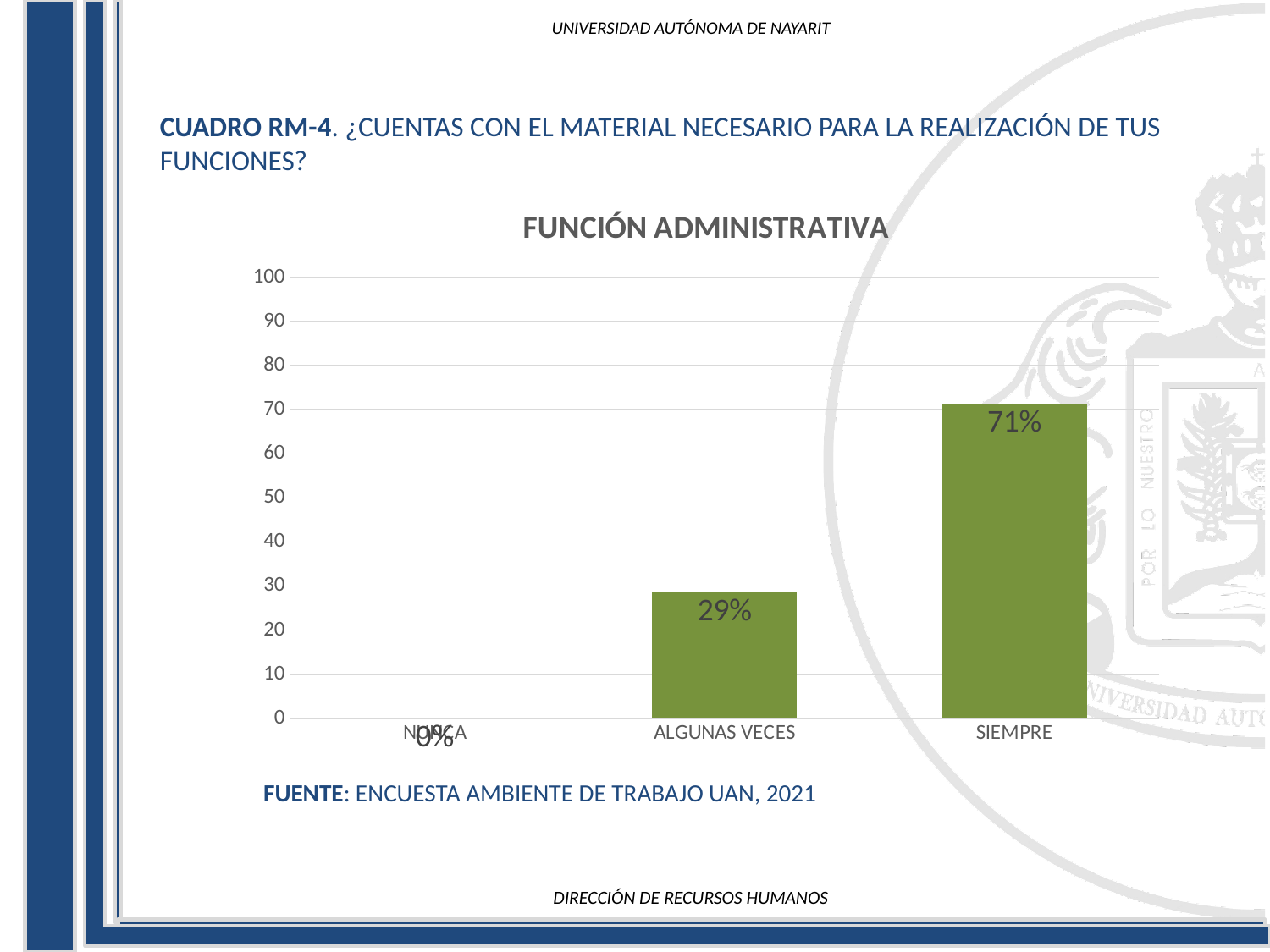
What is the difference between the values for SIEMPRE and ALGUNAS VECES? 42% What is the value for ALGUNAS VECES? 29% What is the value for NUNCA? 0% Is the value for ALGUNAS VECES greater or less than 40? less What kind of chart is shown? bar chart Which category has the lowest value? NUNCA Is the value for SIEMPRE greater or less than 50? greater What is the title of the chart? FUNCIÓN ADMINISTRATIVA What is the value for SIEMPRE? 71% Which category has the highest value? SIEMPRE How many categories are shown on the x axis? 3 Which is larger, the value for ALGUNAS VECES or the value for SIEMPRE? SIEMPRE